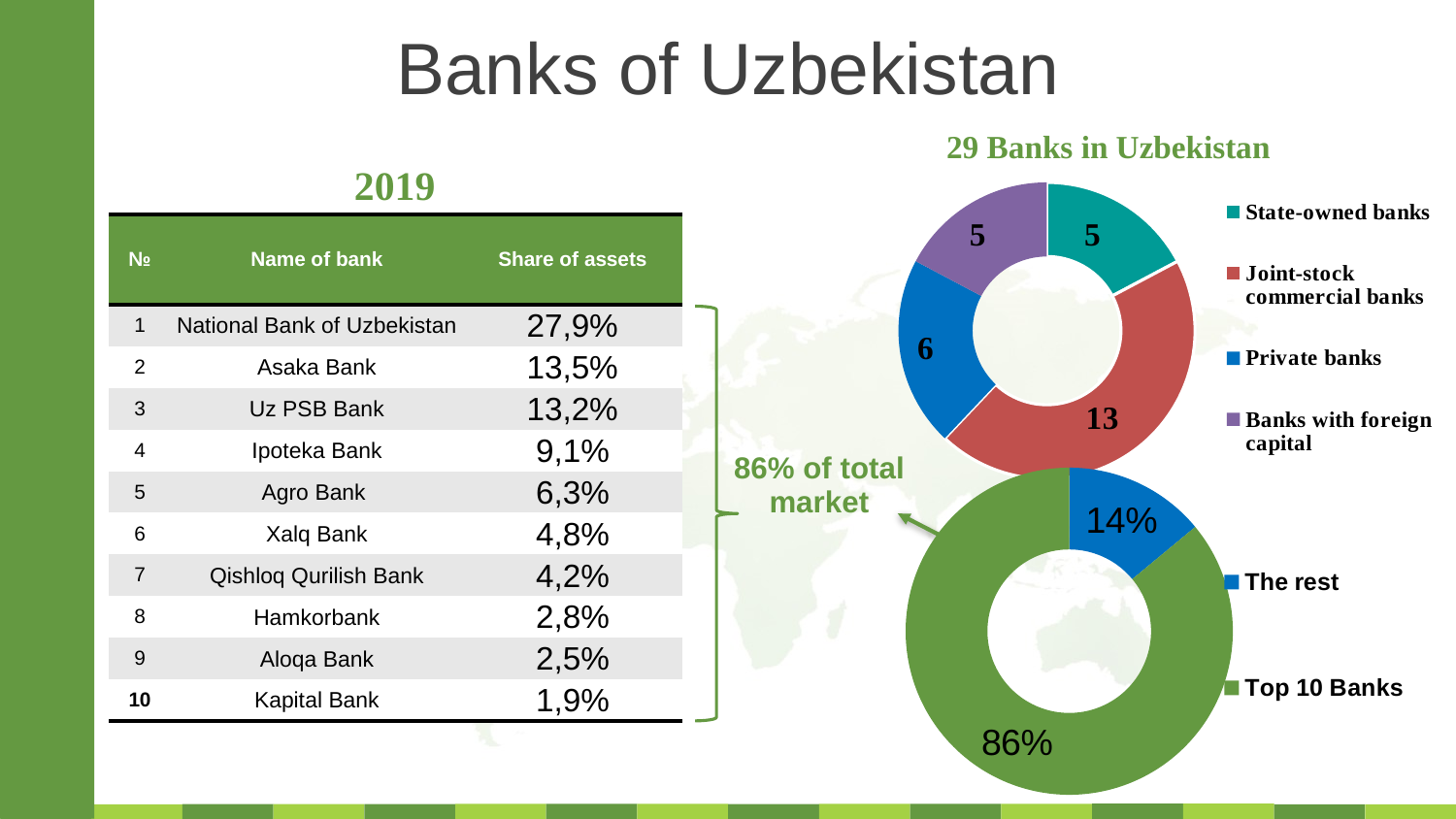
In the lower doughnut chart, what is the difference between the Top 10 Banks share and The rest? 72% What type of chart is the '29 Banks in Uzbekistan' chart? Doughnut chart In the '29 Banks in Uzbekistan' chart, how many joint-stock commercial banks are shown? 13 In the '29 Banks in Uzbekistan' chart, what is the value for state-owned banks? 5 How many categories does the legend of the '29 Banks in Uzbekistan' chart list? 4 In the '29 Banks in Uzbekistan' chart, what is the value for private banks? 6 In the '29 Banks in Uzbekistan' chart, which is larger: private banks or banks with foreign capital? Private banks In the '29 Banks in Uzbekistan' chart, what is the difference between the number of joint-stock commercial banks and private banks? 7 In the '29 Banks in Uzbekistan' chart, what colour represents joint-stock commercial banks? Red In the '29 Banks in Uzbekistan' chart, which category has the largest value? Joint-stock commercial banks In the lower doughnut chart, what is the value for 'The rest'? 14% In the lower doughnut chart, what share do the Top 10 Banks hold? 86%